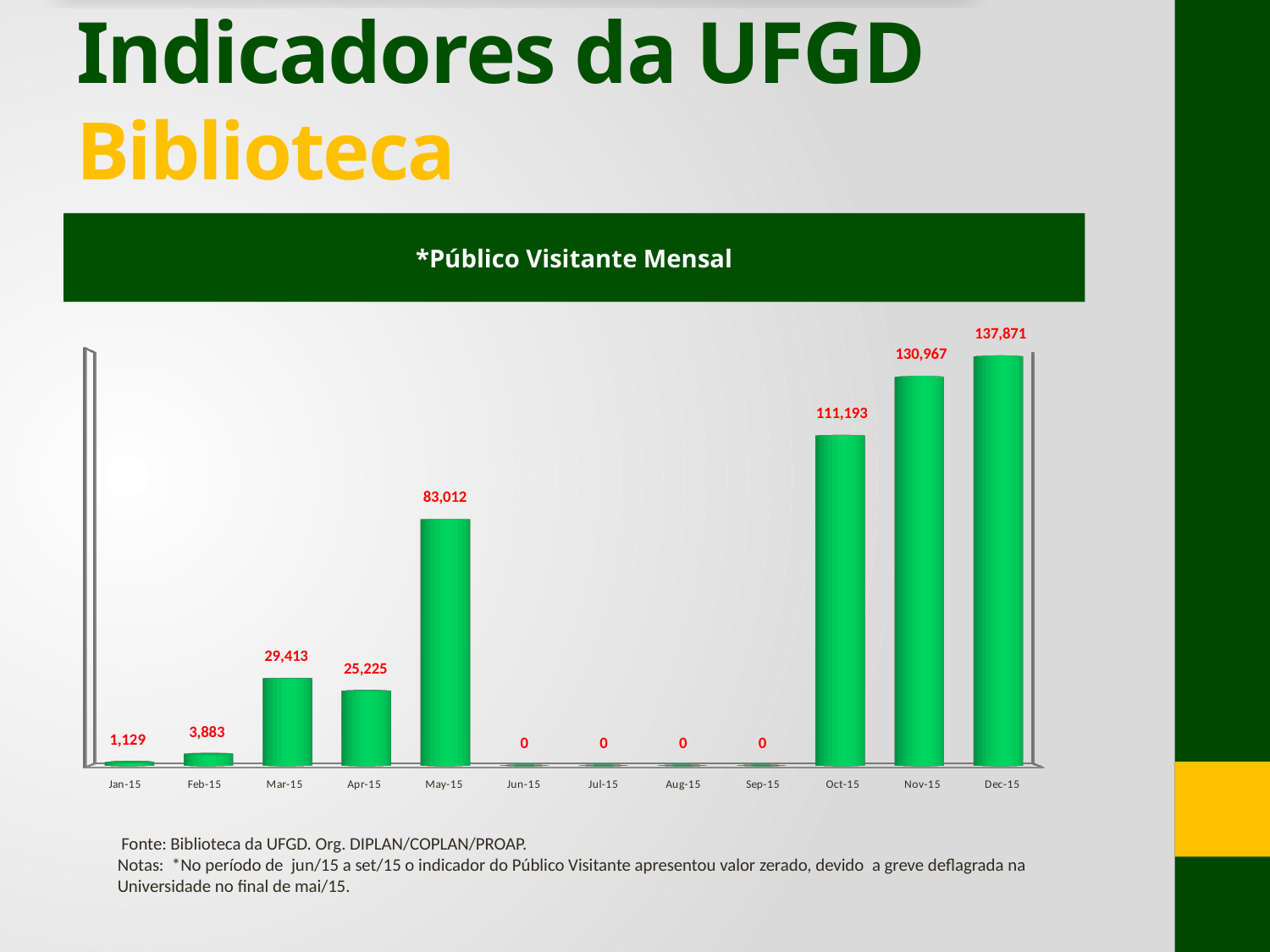
Which month has the highest value in the Público Visitante Mensal chart? Dec-15 How many months show a value of 0 in the Público Visitante Mensal chart? 4 What is the difference between the values for Dec-15 and Nov-15 in the Público Visitante Mensal chart? 6,904 What kind of chart is the Público Visitante Mensal chart? Bar chart What is the value for Feb-15 in the Público Visitante Mensal chart? 3,883 Which is larger in the Público Visitante Mensal chart, the value for Oct-15 or the value for May-15? Oct-15 Which is larger in the Público Visitante Mensal chart, the value for Mar-15 or the value for Apr-15? Mar-15 What is the difference between the values for Mar-15 and Apr-15 in the Público Visitante Mensal chart? 4,188 Do the values rise or fall from Oct-15 to Dec-15 in the Público Visitante Mensal chart? Rise What is the value for May-15 in the Público Visitante Mensal chart? 83,012 What is the value for Dec-15 in the Público Visitante Mensal chart? 137,871 How many months are shown on the x axis of the Público Visitante Mensal chart? 12